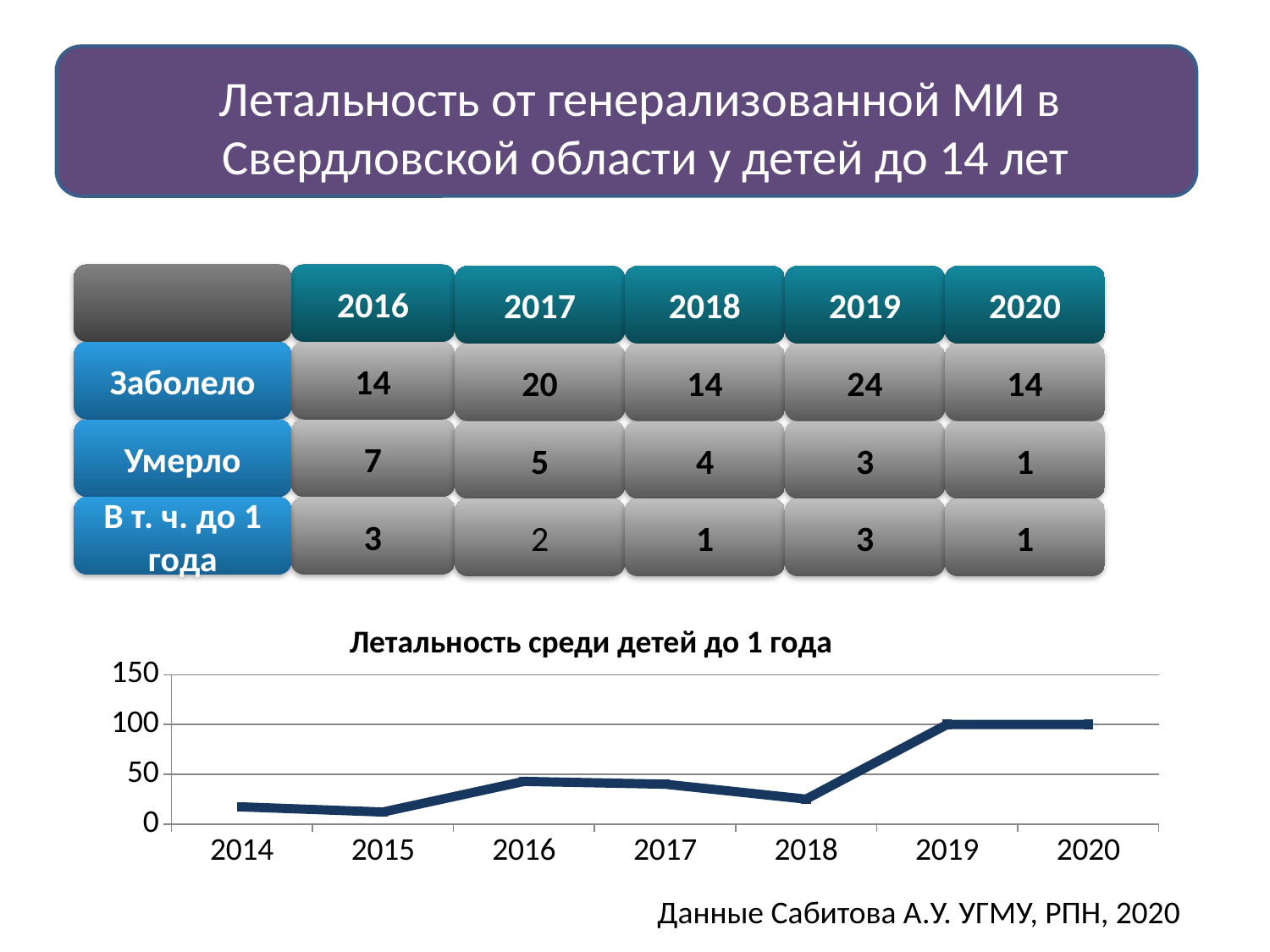
Is the value for 2018 greater or less than 50? less What is the value for 2019 in the chart? 100 What is the title of the chart? Летальность среди детей до 1 года Which is larger, the value for 2016 or the value for 2018? 2016 Is the value for 2016 greater or less than 50? less Does the value rise or fall from 2016 to 2018? fall Does the value rise or fall from 2018 to 2019? rise Is the value for 2014 greater or less than 50? less What kind of chart is shown on the slide? line chart How many years are plotted on the x axis of the chart? 7 Which is larger, the value for 2018 or the value for 2019? 2019